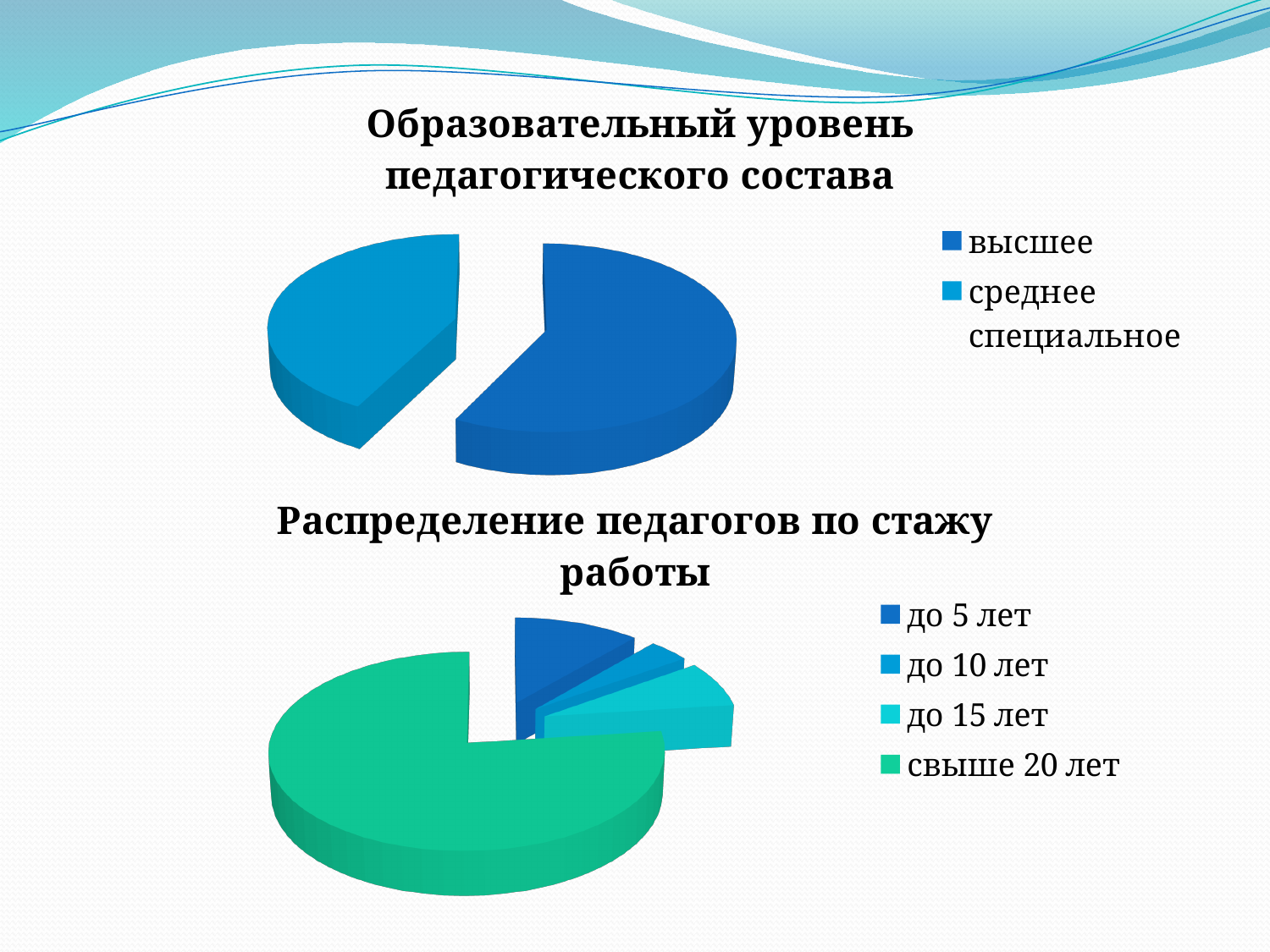
In the bottom chart "Распределение педагогов по стажу работы", how many slices does the pie have? 4 In the top chart, which slice is larger: "высшее" or "среднее специальное"? высшее In the top chart "Образовательный уровень педагогического состава", how many slices does the pie have? 2 How many entries does the legend of the top chart "Образовательный уровень педагогического состава" list? 2 How many entries does the legend of the bottom chart "Распределение педагогов по стажу работы" list? 4 What kind of chart is the bottom chart titled "Распределение педагогов по стажу работы"? pie chart What is the title of the bottom chart on the slide? Распределение педагогов по стажу работы In the top chart "Образовательный уровень педагогического состава", which category has the smallest slice? среднее специальное In the bottom chart "Распределение педагогов по стажу работы", which category has the largest slice? свыше 20 лет In the top chart "Образовательный уровень педагогического состава", which category has the largest slice? высшее What kind of chart is the top chart titled "Образовательный уровень педагогического состава"? pie chart In the bottom chart "Распределение педагогов по стажу работы", which slice is larger: "до 5 лет" or "свыше 20 лет"? свыше 20 лет